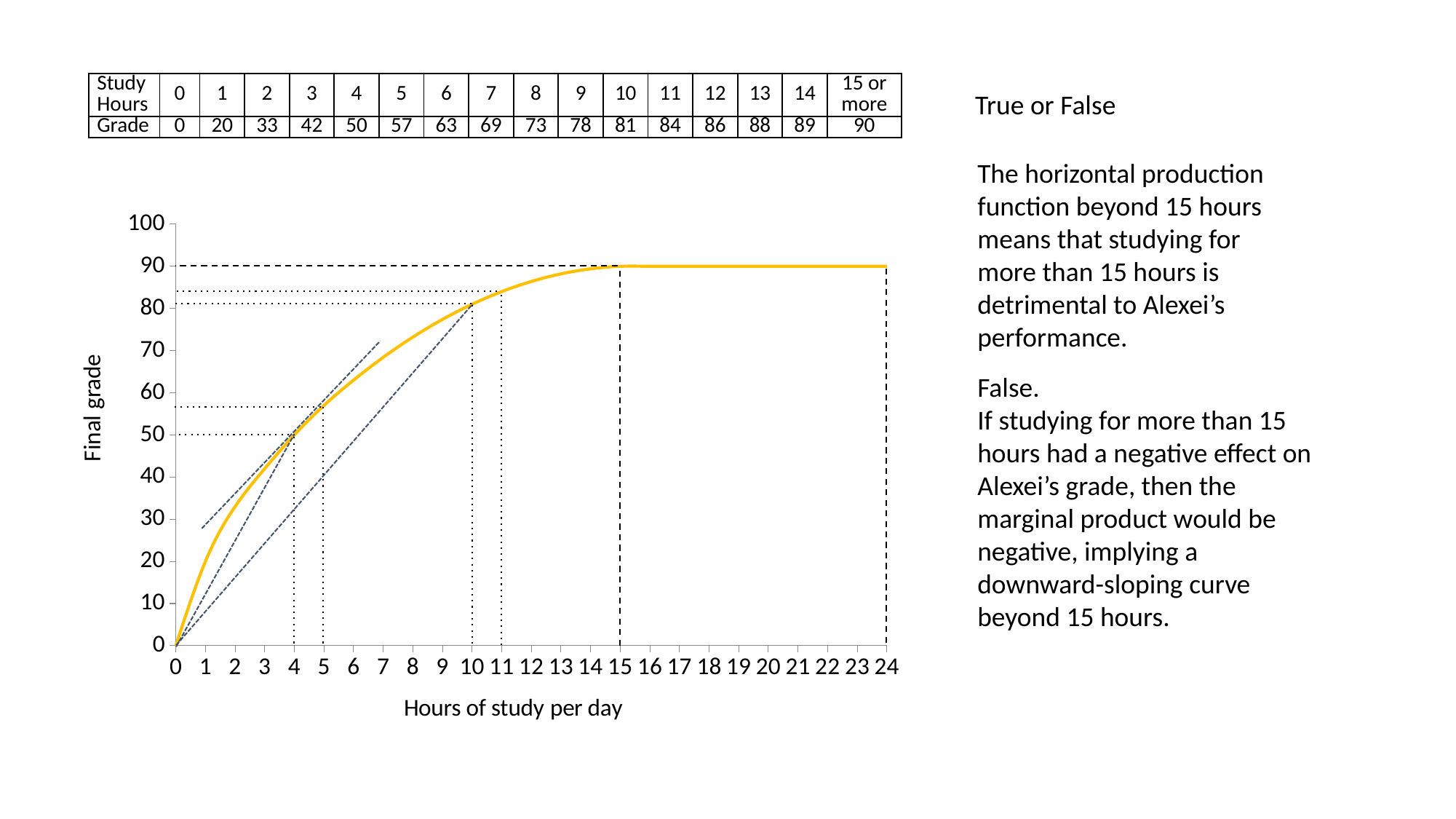
What is the highest final grade reached on the curve? 90 What is the title of the y axis of the chart? Final grade What is the difference between the final grade at 10 hours and the final grade at 4 hours of study? 31 What is the final grade for 4 hours of study per day? 50 What kind of chart is shown on the slide? line chart How does the final grade change as hours of study per day increase from 0 to 15? It rises Which gives a higher final grade: 5 hours or 7 hours of study per day? 7 hours What is the title of the x axis of the chart? Hours of study per day At how many study hours is the final grade lowest? 0 What is the final grade for 10 hours of study per day? 81 Is the final grade for 12 hours of study greater or less than 80? greater What is the final grade for 15 or more hours of study per day? 90